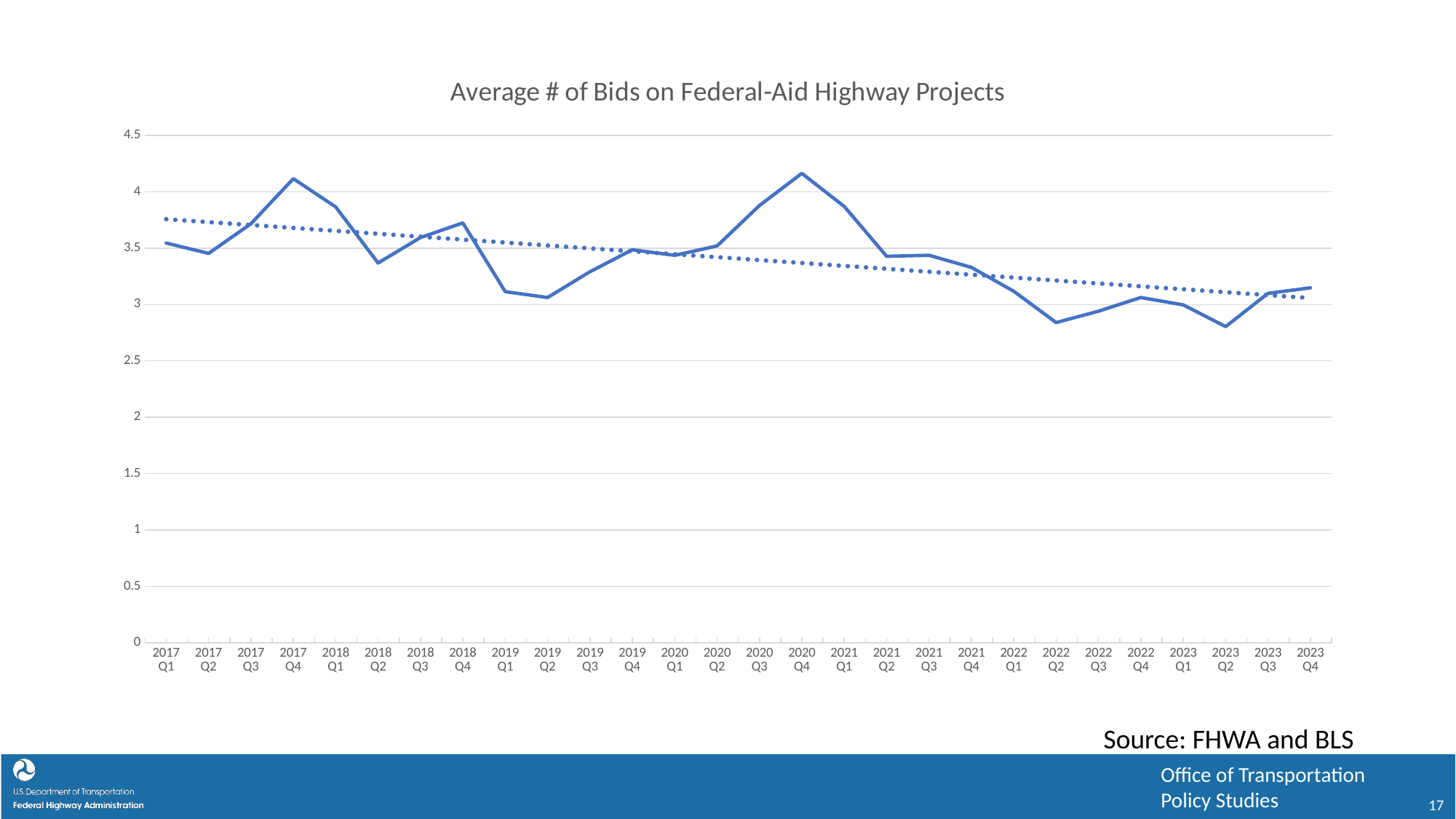
What is the title of the chart? Average # of Bids on Federal-Aid Highway Projects Is the value for 2018 Q2 greater or less than 3.5? less Is the value for 2021 Q1 greater or less than 3.5? greater Is the value for 2022 Q2 greater or less than 3? less How many quarterly data points are plotted along the x axis? 28 Overall, does the average number of bids rise or fall from 2017 Q1 to 2023 Q4? fall What kind of chart is shown on the slide? line chart Which is larger, the value for 2020 Q4 or the value for 2022 Q2? 2020 Q4 Which is larger, the value for 2019 Q2 or the value for 2017 Q4? 2017 Q4